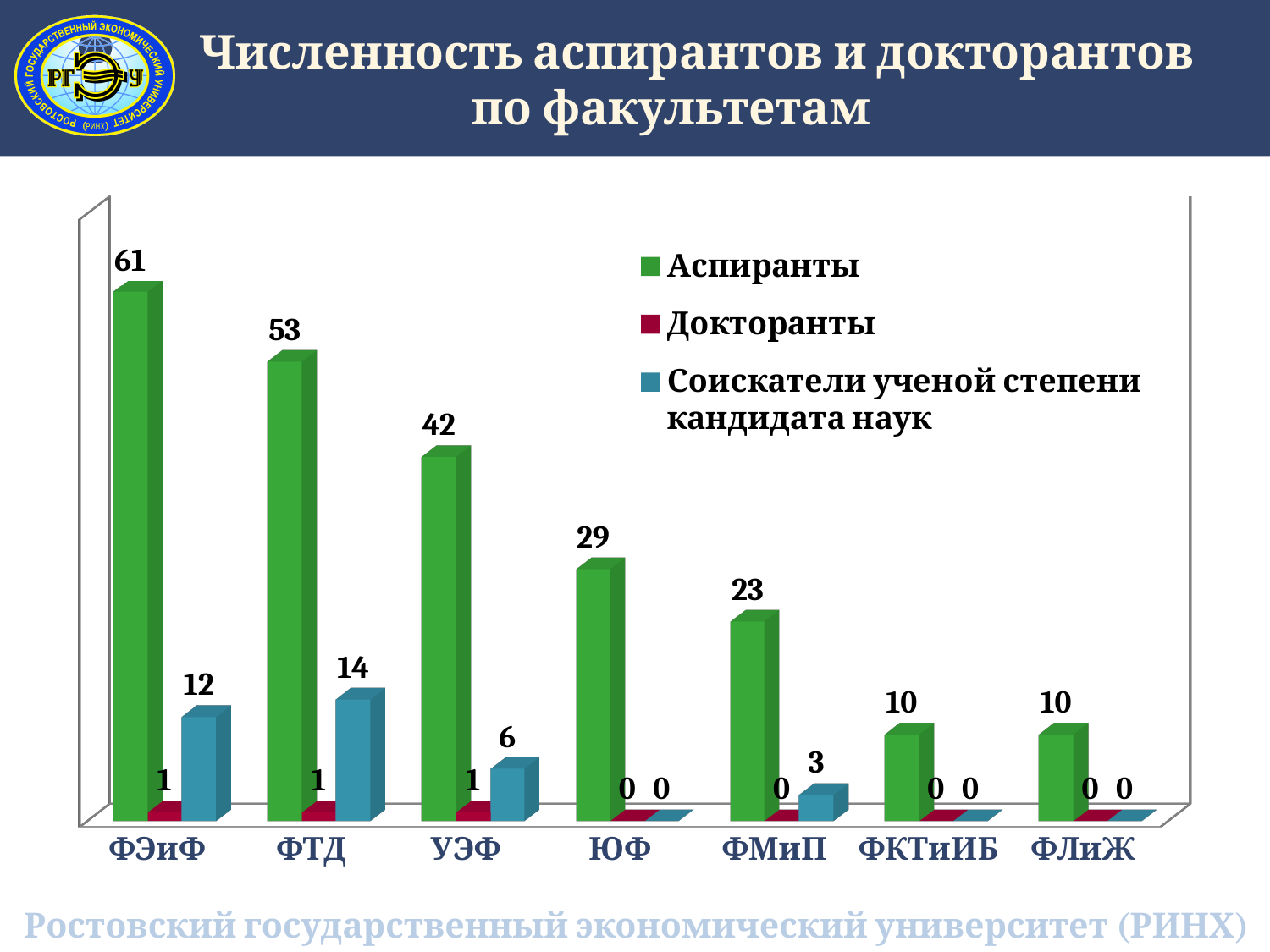
How many series does the legend list? 3 What kind of chart is shown on the slide? Bar chart Which is larger: the Аспиранты value for ФМиП or for ЮФ? ЮФ Which faculty has the highest value for Аспиранты? ФЭиФ What is the value for Соискатели ученой степени кандидата наук at ФТД? 14 What is the value for Докторанты at УЭФ? 1 How many faculties are shown on the x axis? 7 Which faculty has the highest value for Соискатели ученой степени кандидата наук? ФТД What is the value for Аспиранты at ФЭиФ? 61 What is the difference between the Аспиранты values for ФЭиФ and ФТД? 8 What is the value for Соискатели ученой степени кандидата наук at ФМиП? 3 What is the difference between the Аспиранты values for УЭФ and ЮФ? 13